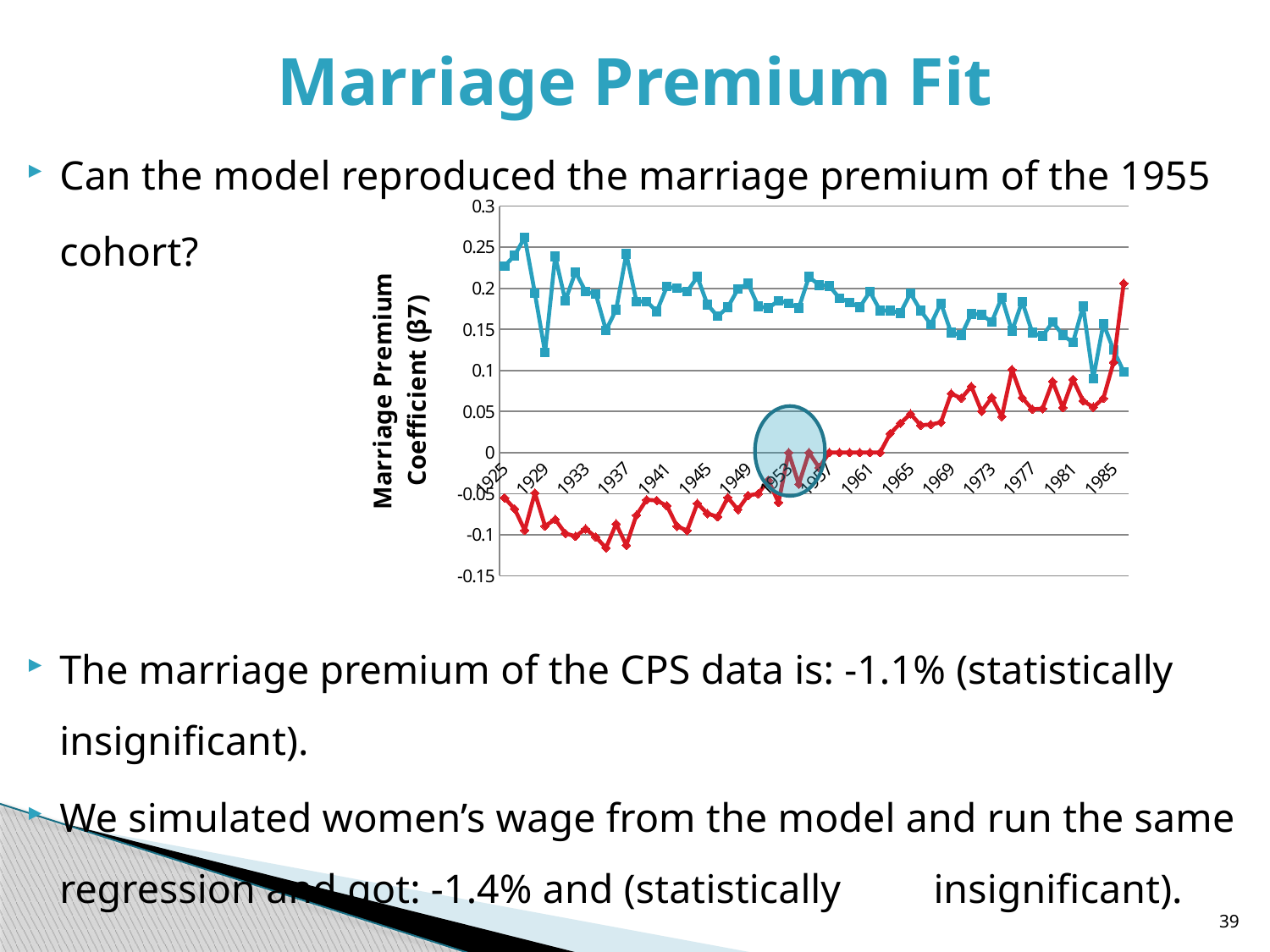
How many data series (lines) are plotted on the chart? 2 What kind of chart is shown on the slide? line chart Is the value of the blue series at 1925 greater or less than 0.2? greater Does the red series generally rise or fall from 1925 to 1985? rise Does the blue series generally rise or fall from 1925 to 1985? fall What is the highest value shown on the vertical axis of the chart? 0.3 Is the value of the red series at 1933 greater or less than 0? less At 1945, which series has the larger value, the blue series or the red series? the blue series Is the value of the red series at 1961 greater or less than 0.05? less How many year labels are shown along the x axis of the chart? 16 What is the label on the vertical axis of the chart? Marriage Premium Coefficient (β7)